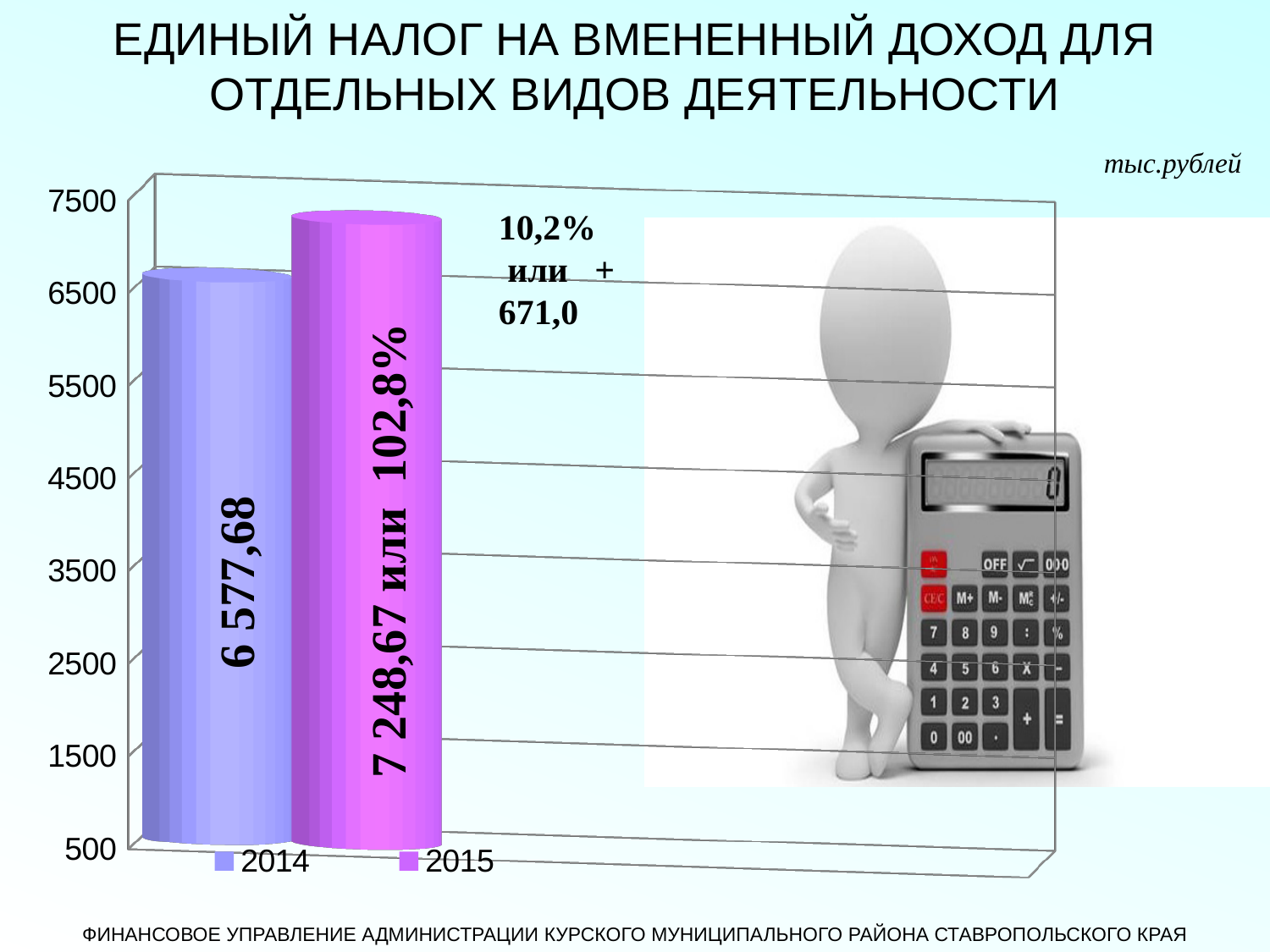
What percentage growth from 2014 to 2015 is printed on the slide? 10,2% What percentage of the 2014 value does the 2015 value represent, as printed on the 2015 bar? 102,8% Is the value for 2014 greater or less than 6500? greater In what units are the values on the chart expressed? тыс.рублей What type of chart is shown on the slide? bar chart What is the value for 2014? 6 577,68 Which year has the higher value, 2014 or 2015? 2015 Which year has the highest value on the chart? 2015 What is the value for 2015? 7 248,67 By how much did the value increase from 2014 to 2015, as printed on the slide? 671,0 How many bars are shown on the chart? 2 Which year has the lowest value on the chart? 2014